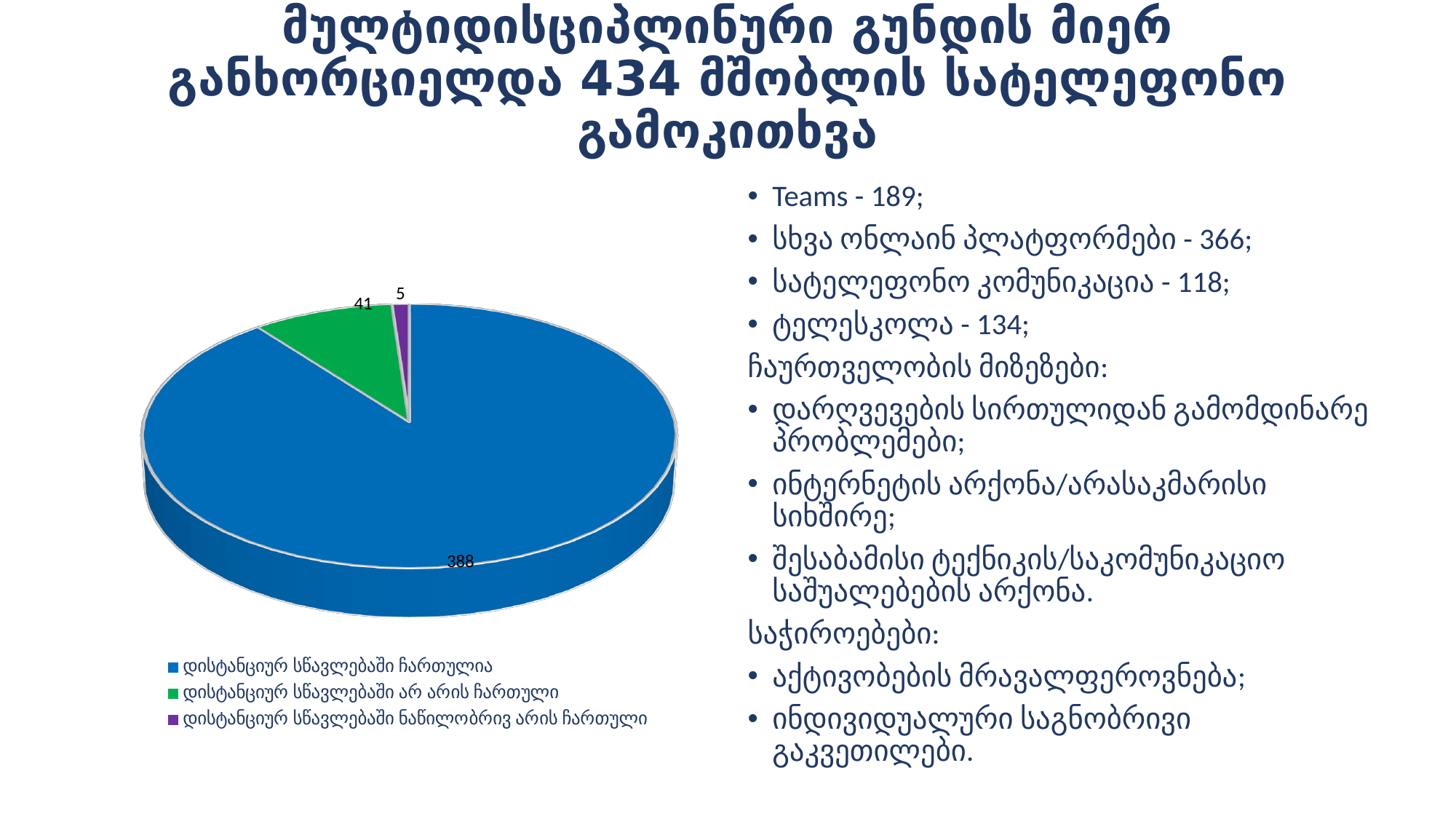
What value is shown for the slice labelled "დისტანციურ სწავლებაში ნაწილობრივ არის ჩართული"? 5 What value is shown for the slice labelled "დისტანციურ სწავლებაში ჩართულია"? 388 How many slices does the pie chart have? 3 What colour is the slice for "დისტანციურ სწავლებაში არ არის ჩართული"? Green What kind of chart is shown on the slide? Pie chart What value is shown for the slice labelled "დისტანციურ სწავლებაში არ არის ჩართული"? 41 Which is larger: the value for "დისტანციურ სწავლებაში არ არის ჩართული" or for "დისტანციურ სწავლებაში ნაწილობრივ არის ჩართული"? დისტანციურ სწავლებაში არ არის ჩართული How many entries does the legend list? 3 What is the difference between the values for "დისტანციურ სწავლებაში ჩართულია" and "დისტანციურ სწავლებაში არ არის ჩართული"? 347 What is the sum of all three slice values in the pie chart? 434 Which category has the smallest slice of the pie? დისტანციურ სწავლებაში ნაწილობრივ არის ჩართული Which category has the largest slice of the pie? დისტანციურ სწავლებაში ჩართულია